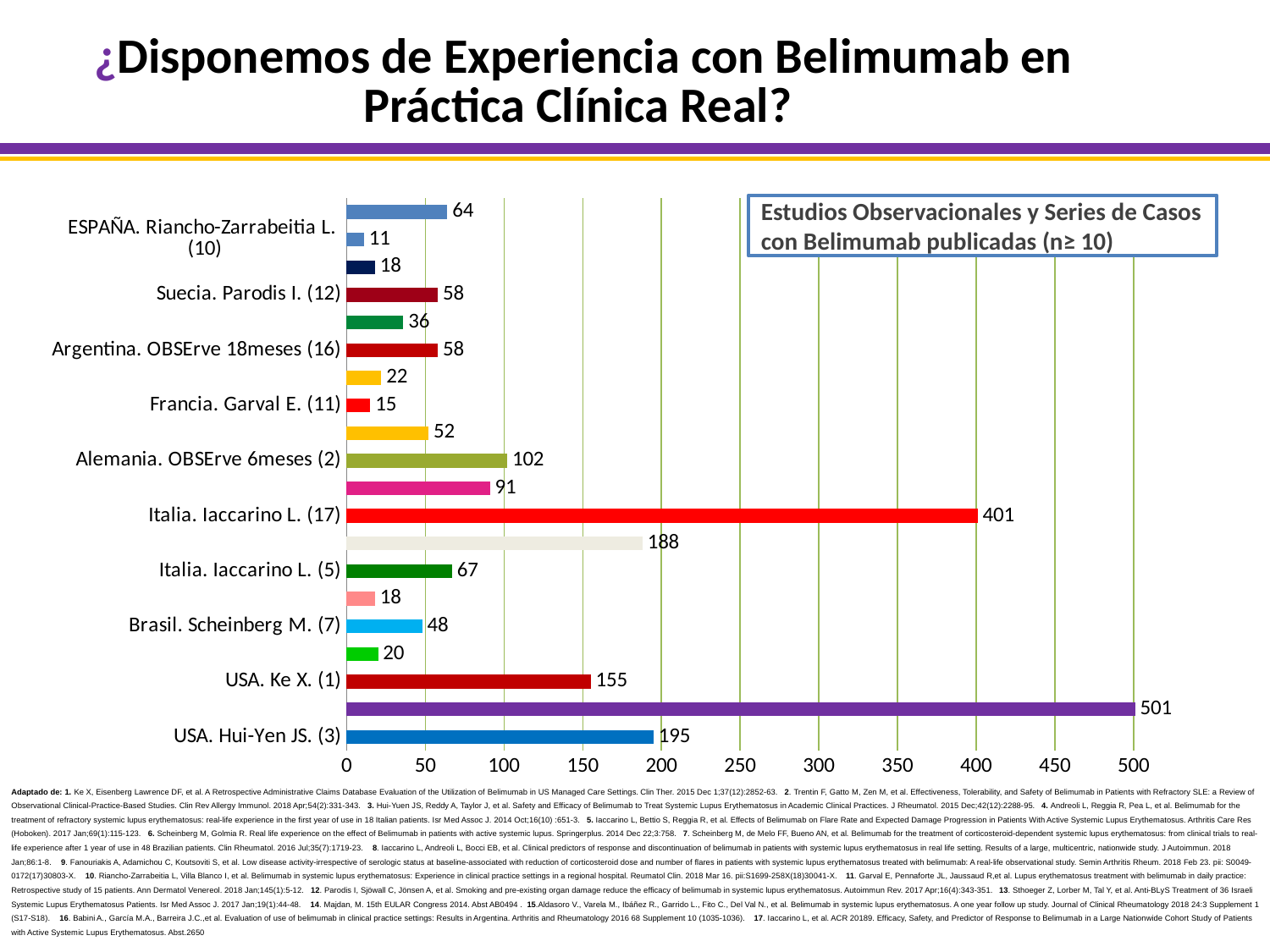
What type of chart is shown on the slide? bar chart What is the value for Brasil. Scheinberg M. (7)? 48 What is the difference between the values for Italia. Iaccarino L. (17) and Italia. Iaccarino L. (5)? 334 What is the value for Italia. Iaccarino L. (17)? 401 What is the largest value shown in the chart? 501 What is the value for USA. Hui-Yen JS. (3)? 195 Which is larger, the value for USA. Hui-Yen JS. (3) or USA. Ke X. (1)? USA. Hui-Yen JS. (3) How many bars are plotted in the chart? 20 What is the value for Francia. Garval E. (11)? 15 What is the value for ESPAÑA. Riancho-Zarrabeitia L. (10)? 11 What does the text box in the upper right of the chart say? Estudios Observacionales y Series de Casos con Belimumab publicadas (n≥ 10) What is the value for Alemania. OBSErve 6meses (2)? 102